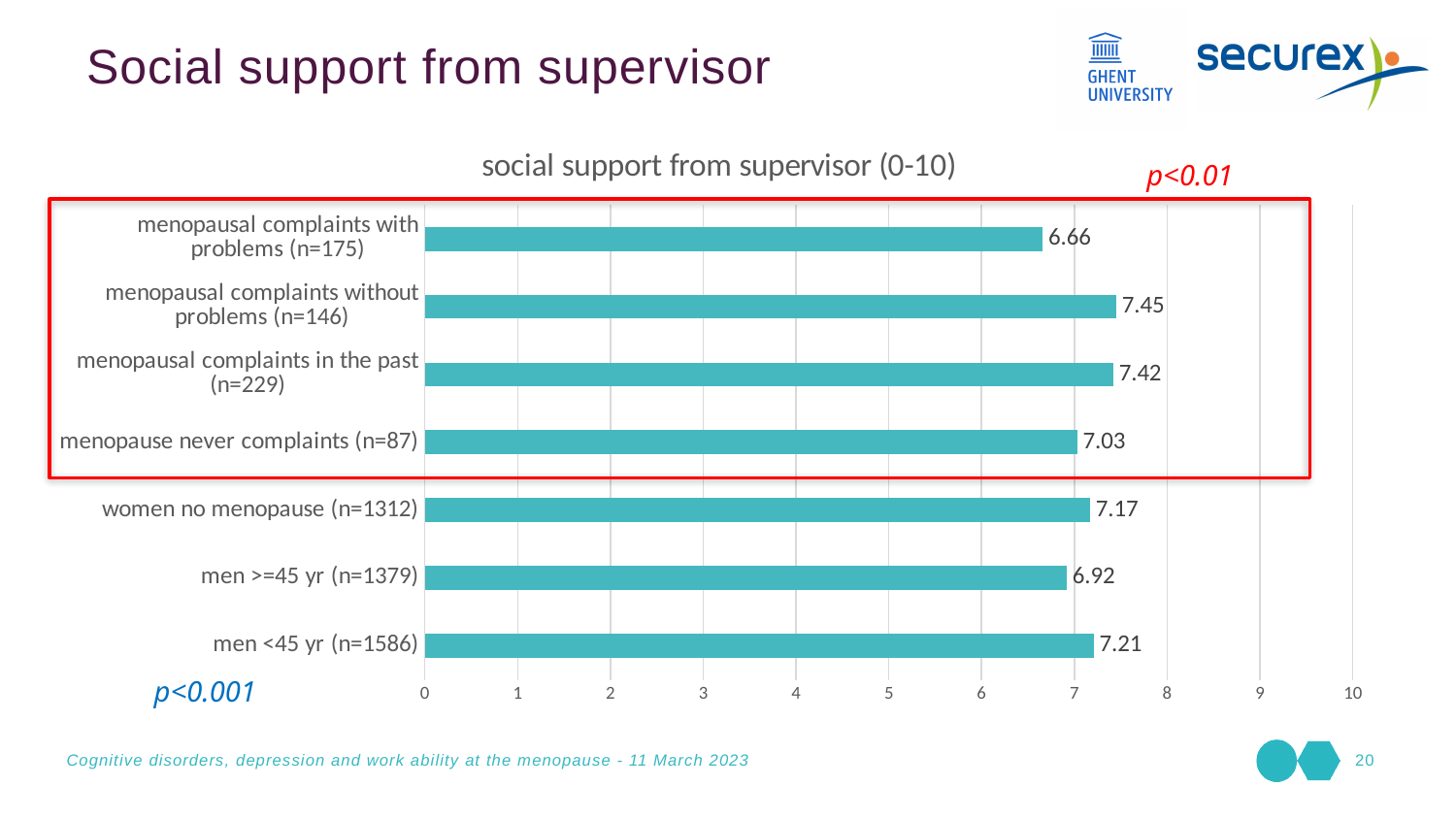
What is the difference between the values for menopausal complaints without problems (n=146) and menopausal complaints with problems (n=175)? 0.79 What is the value for menopausal complaints with problems (n=175)? 6.66 How many categories are shown in the chart? 7 What kind of chart is shown on the slide? bar chart What is the value for men <45 yr (n=1586)? 7.21 Which category has the highest value? menopausal complaints without problems (n=146) What is the value for women no menopause (n=1312)? 7.17 Is the value for menopause never complaints (n=87) greater or less than 7? greater Which is larger: the value for men >=45 yr (n=1379) or men <45 yr (n=1586)? men <45 yr (n=1586) Which category has the lowest value? menopausal complaints with problems (n=175) What is the maximum value shown on the x axis? 10 What is the title of the chart? social support from supervisor (0-10)